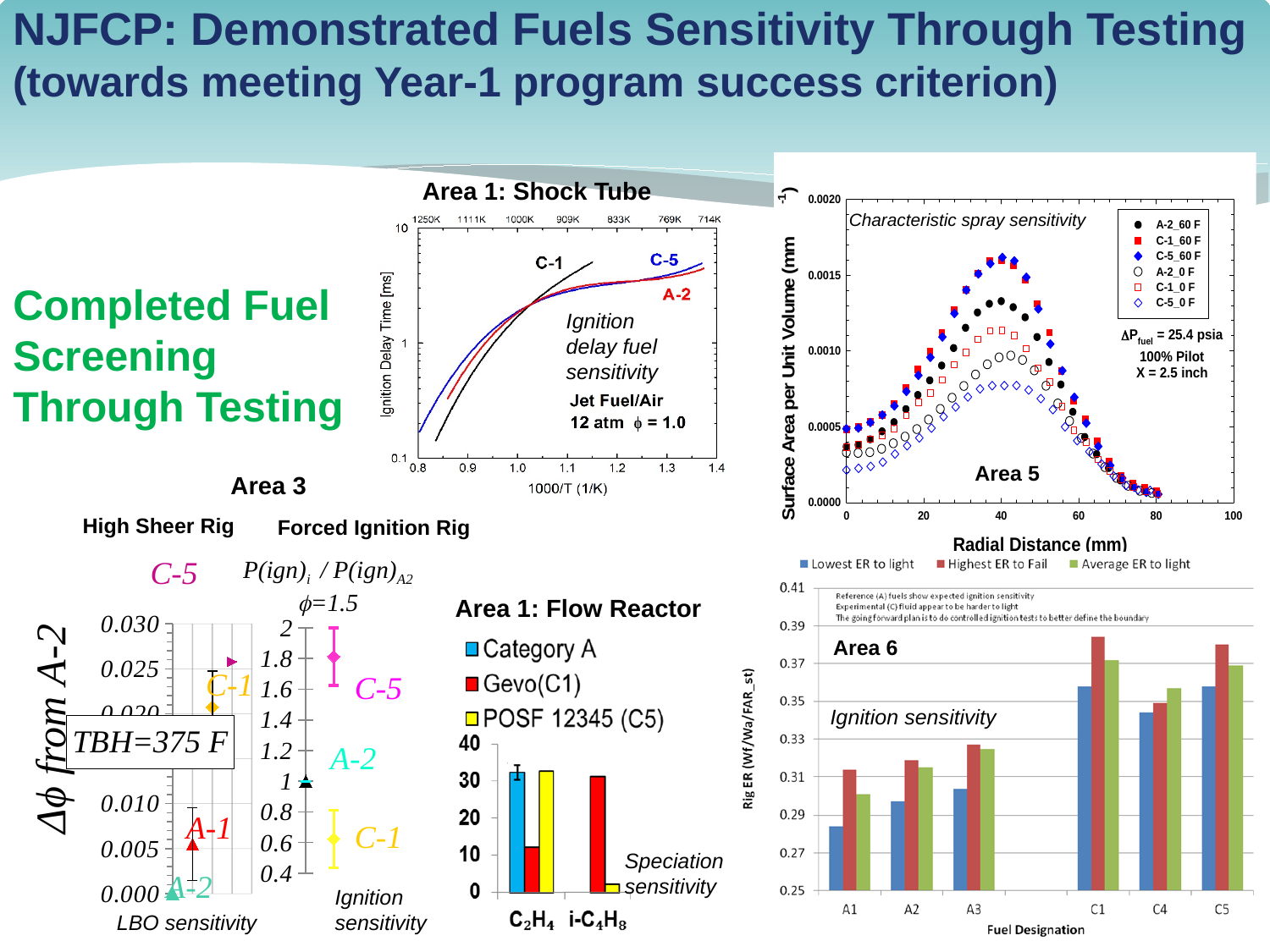
In the Area 1: Flow Reactor chart, which is larger for C2H4, Category A or Gevo(C1)? Category A In the Area 1: Flow Reactor chart, how many series does the legend list? 3 In the Area 6 chart, is the Highest ER to Fail value for C1 greater or less than 0.37? greater In the Area 5 chart, how many series does the legend list? 6 What kind of chart is the Area 1: Shock Tube chart? line chart In the Area 6 chart, how many series does the legend list? 3 In the Area 5 chart, which series reaches the highest surface area per unit volume? C-5_60 F In the Area 1: Flow Reactor chart, is the POSF 12345 (C5) value for i-C4H8 greater or less than 10? less In the Area 6 chart, which fuel designation has the lowest value for Lowest ER to light? A1 In the Area 6 chart, how many fuel designations are shown on the x axis? 6 In the Area 6 chart, is the Lowest ER to light value for C1 greater or less than 0.35? greater